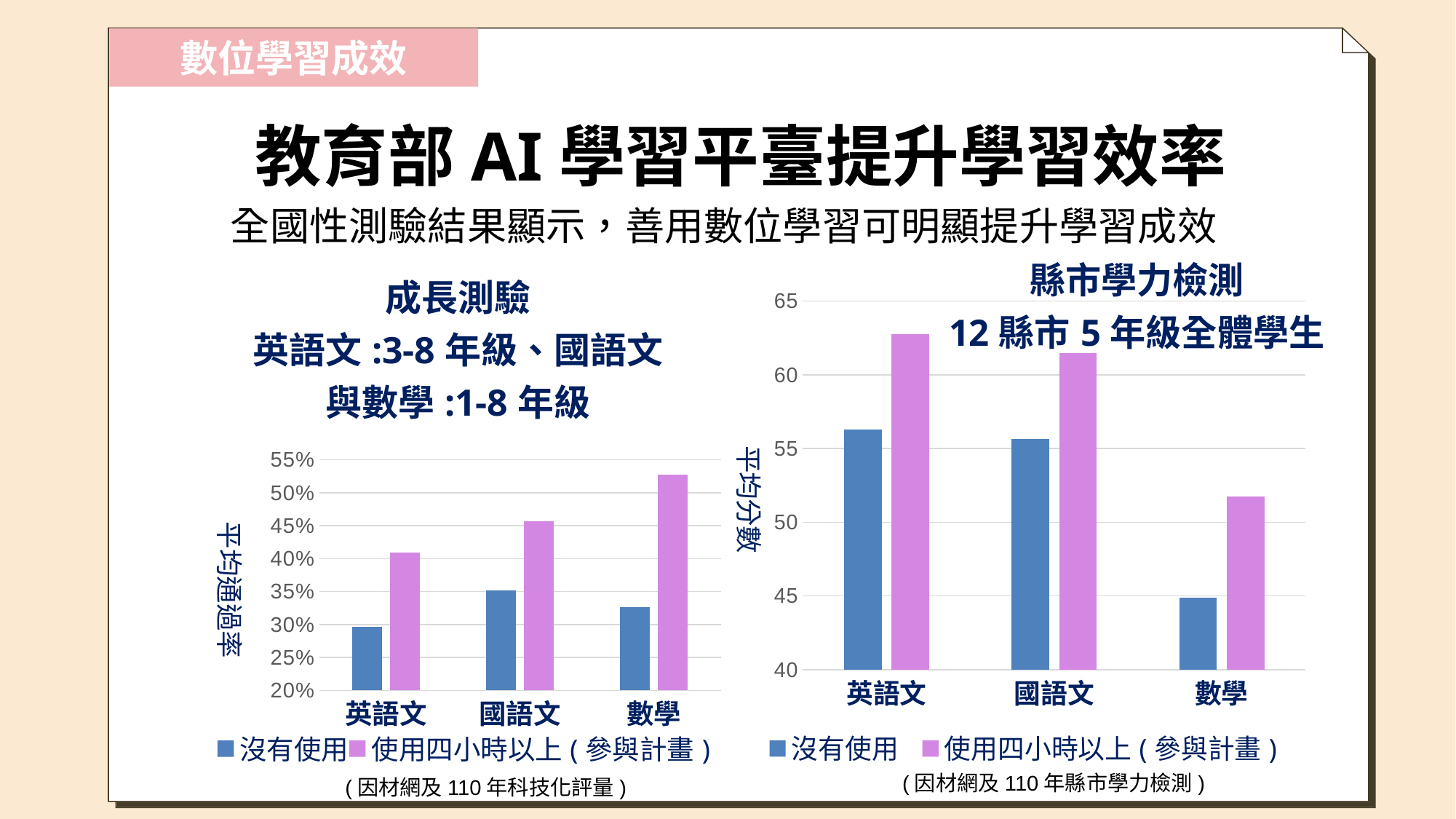
In the 縣市學力檢測 chart, which is larger for 國語文: the 沒有使用 bar or the 使用四小時以上（參與計畫） bar? 使用四小時以上（參與計畫） In the 成長測驗 chart, is the 使用四小時以上（參與計畫） value for 數學 greater or less than 50%? greater What is the y-axis label of the 縣市學力檢測 chart? 平均分數 How many categories are shown on the x axis of the 縣市學力檢測 chart on the right? 3 How many series does the legend of the 成長測驗 chart list? 2 In the 成長測驗 chart, which category has the highest 使用四小時以上（參與計畫） bar? 數學 In the 縣市學力檢測 chart, which category has the highest 使用四小時以上（參與計畫） bar? 英語文 What kind of chart is the 成長測驗 chart on the left? bar chart In the 縣市學力檢測 chart, which category has the lowest 沒有使用 bar? 數學 In the 成長測驗 chart, which category has the lowest 沒有使用 bar? 英語文 In the 成長測驗 chart, do the 使用四小時以上（參與計畫） bars rise or fall from 英語文 to 數學? rise